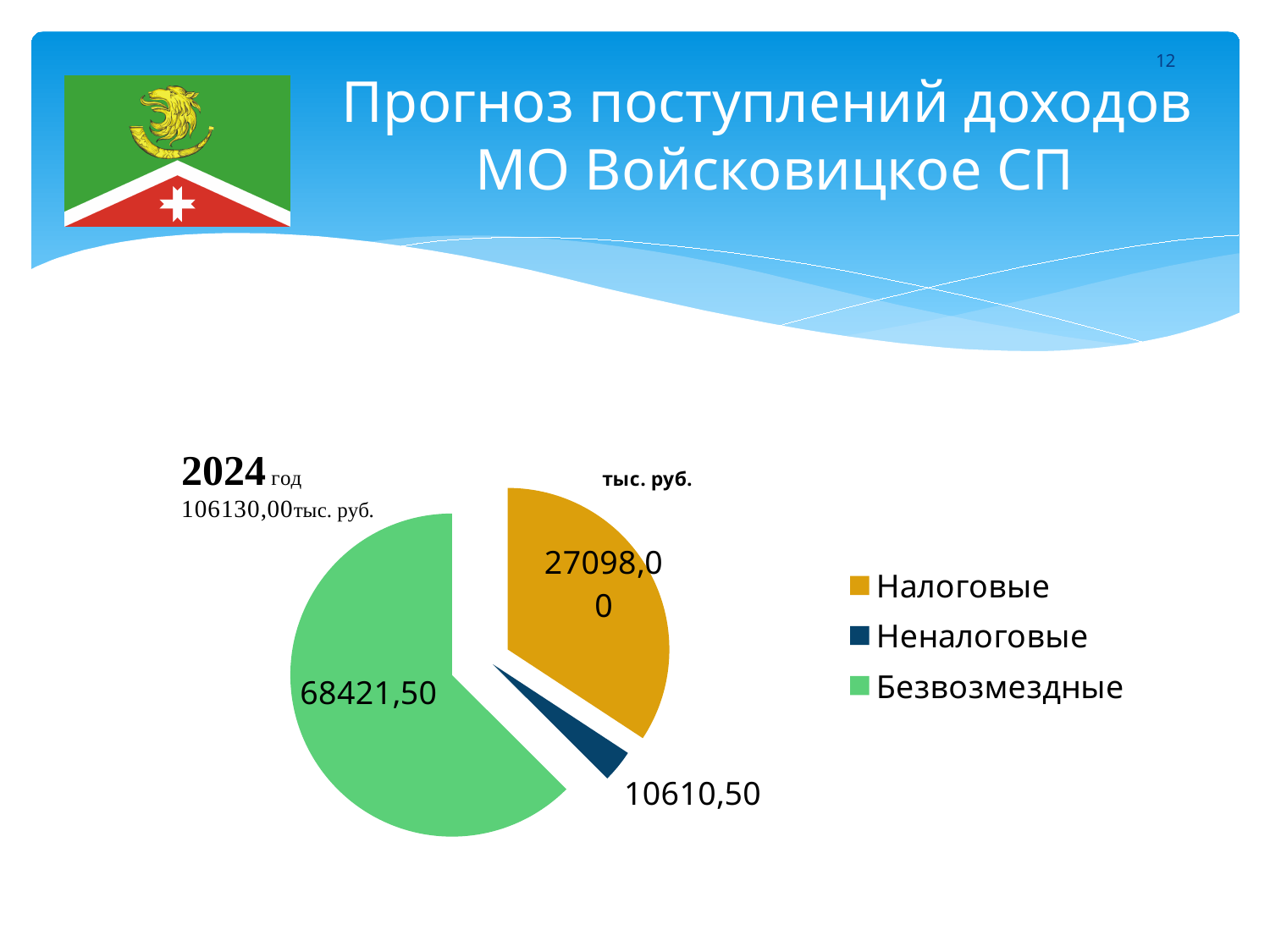
What is the value for Налоговые in the pie chart? 27098,00 What is the difference between the values for Налоговые and Неналоговые? 16487,50 What is the value for Неналоговые in the pie chart? 10610,50 What kind of chart is shown on the slide? pie chart What is the total of all slices in the pie chart, as stated on the slide? 106130,00 тыс. руб. What is the value for Безвозмездные in the pie chart? 68421,50 Which category has the smallest slice in the pie chart? Неналоговые Which category has the largest slice in the pie chart? Безвозмездные What is the difference between the values for Безвозмездные and Налоговые? 41323,50 Which is larger, the value for Налоговые or the value for Неналоговые? Налоговые How many categories does the pie chart have? 3 What colour is the Безвозмездные slice in the pie chart? green